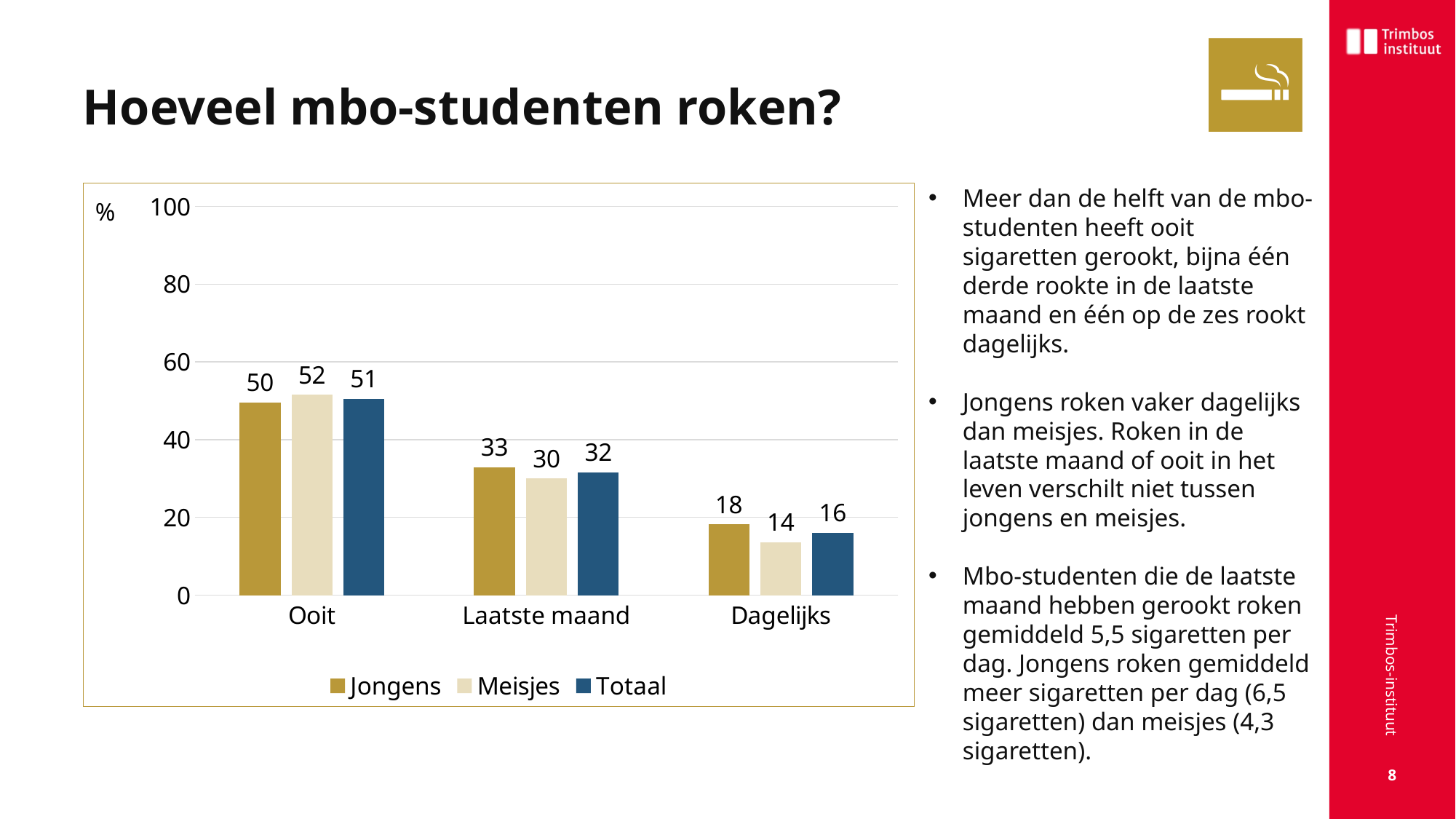
Is the value for Totaal in the Ooit category greater or less than 40? greater Which category has the lowest value for Meisjes? Dagelijks How many categories are shown on the x axis? 3 What is the value for Meisjes in the Laatste maand category? 30 What kind of chart is shown on the slide? bar chart What is the value for Totaal in the Dagelijks category? 16 In the Laatste maand category, which is larger: Jongens or Meisjes? Jongens What is the difference between Jongens and Meisjes in the Dagelijks category? 4 Which series is shown in dark blue in the legend? Totaal Which category has the highest value for Totaal? Ooit What is the value for Jongens in the Ooit category? 50 How many series does the legend list? 3